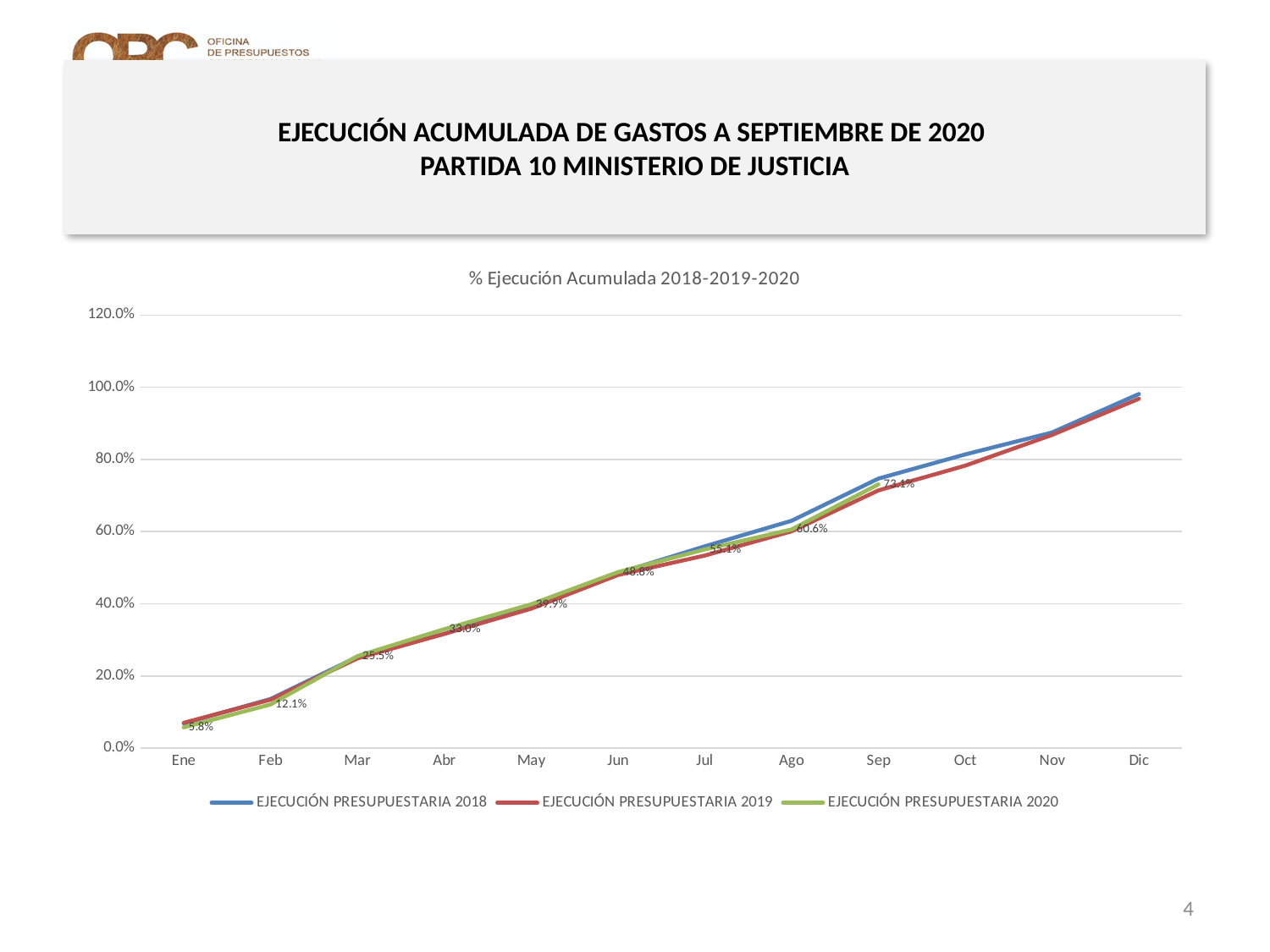
Do the values for EJECUCIÓN PRESUPUESTARIA 2018 rise or fall from Ene to Dic? rise What is the value for EJECUCIÓN PRESUPUESTARIA 2020 in Ago? 60.6% What is the difference between the 2020 values for Feb and Ene? 6.3% What is the value for EJECUCIÓN PRESUPUESTARIA 2020 in Mar? 25.5% What is the title of the chart? % Ejecución Acumulada 2018-2019-2020 How many series does the legend list? 3 What is the value for EJECUCIÓN PRESUPUESTARIA 2020 in Ene? 5.8% What is the value for EJECUCIÓN PRESUPUESTARIA 2020 in Sep? 73.1% How many months are shown along the x axis? 12 What kind of chart is shown on the slide? line chart What is the difference between the 2020 values for Sep and Ago? 12.5% Is the value for EJECUCIÓN PRESUPUESTARIA 2018 in Dic greater or less than 80.0%? greater